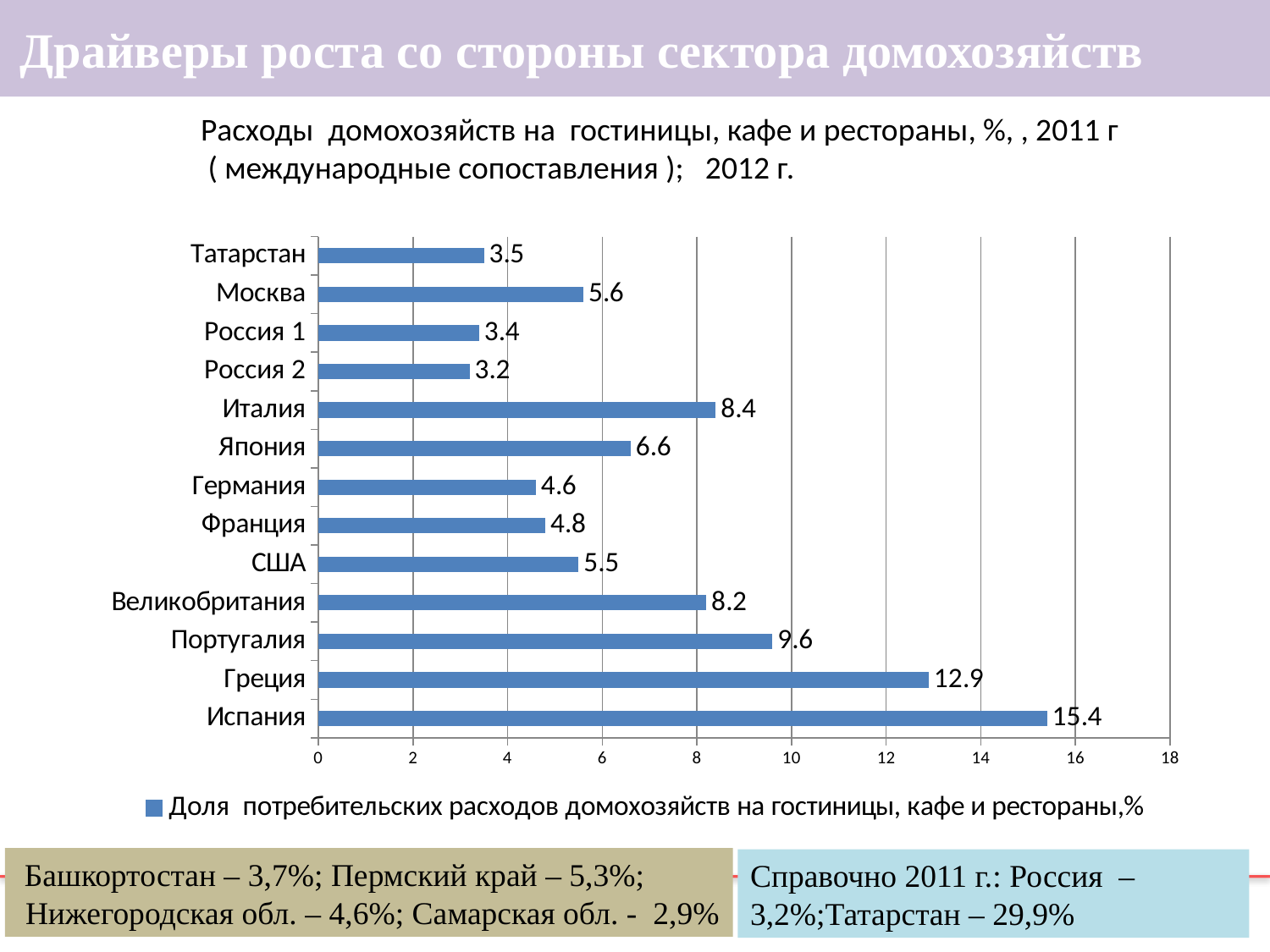
What is the value for Испания? 15.4 What is the legend entry for the series? Доля потребительских расходов домохозяйств на гостиницы, кафе и рестораны,% Is the value for Великобритания greater or less than 8? greater What is the value for Япония? 6.6 How many series does the legend list? 1 Which category has the lowest value? Россия 2 Which is larger, the value for Москва or the value for США? Москва What kind of chart is shown? bar chart What is the difference between the values for Греция and Португалия? 3.3 How many categories are shown on the chart? 13 What is the value for Татарстан? 3.5 Which category has the highest value? Испания